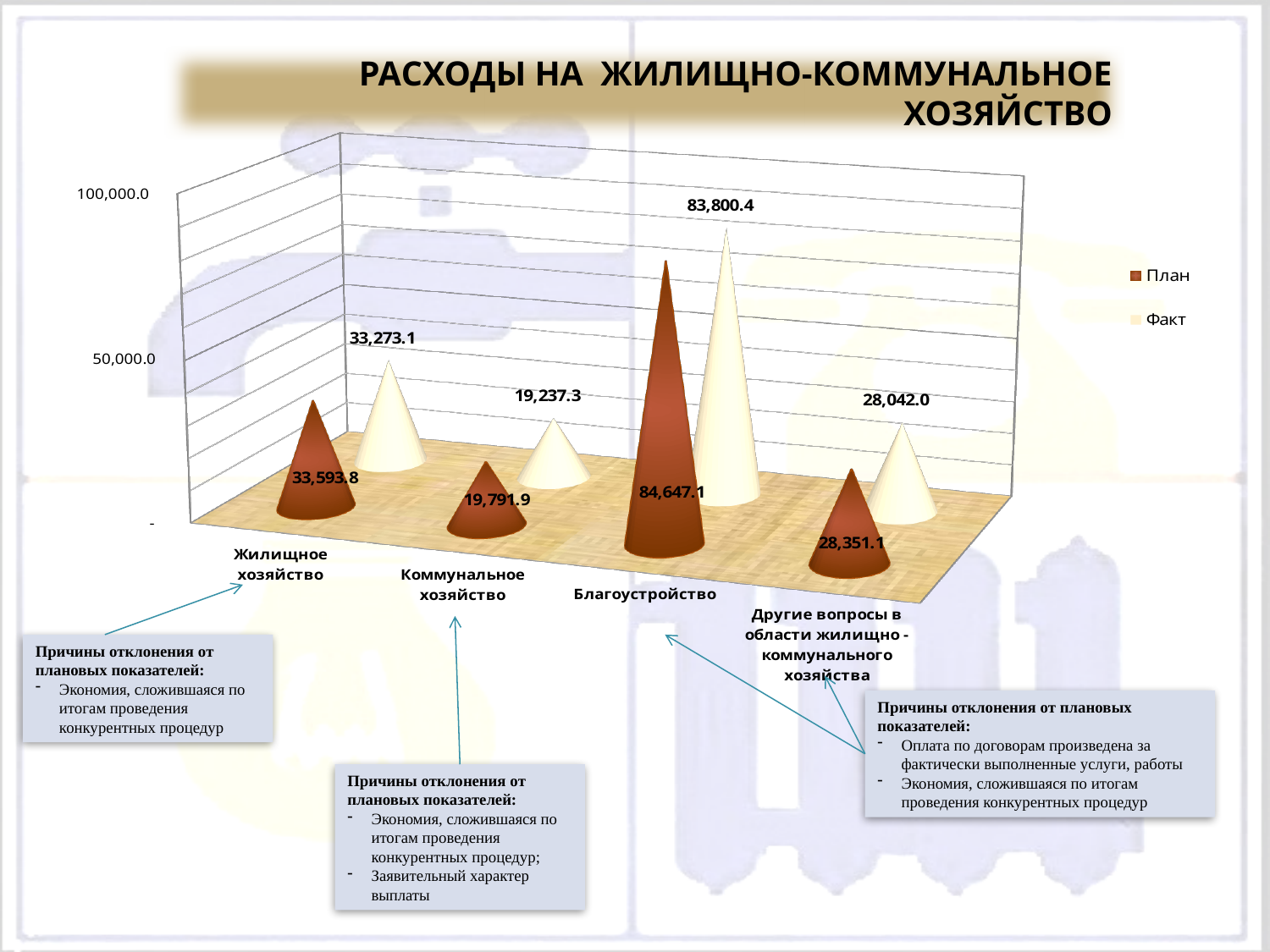
What is the difference between the План and Факт values for Благоустройство? 846.7 Which category has the highest Факт value? Благоустройство What is the Факт value for Коммунальное хозяйство? 19,237.3 How many series does the chart legend list? 2 What is the difference between the План and Факт values for Коммунальное хозяйство? 554.6 Which is larger for Жилищное хозяйство, the План value or the Факт value? План Which category has the lowest План value? Коммунальное хозяйство What is the Факт value for Жилищное хозяйство? 33,273.1 How many categories are shown on the x axis of the chart? 4 What is the План value for Благоустройство? 84,647.1 What is the title of the chart on the slide? РАСХОДЫ НА ЖИЛИЩНО-КОММУНАЛЬНОЕ ХОЗЯЙСТВО What is the План value for Другие вопросы в области жилищно-коммунального хозяйства? 28,351.1